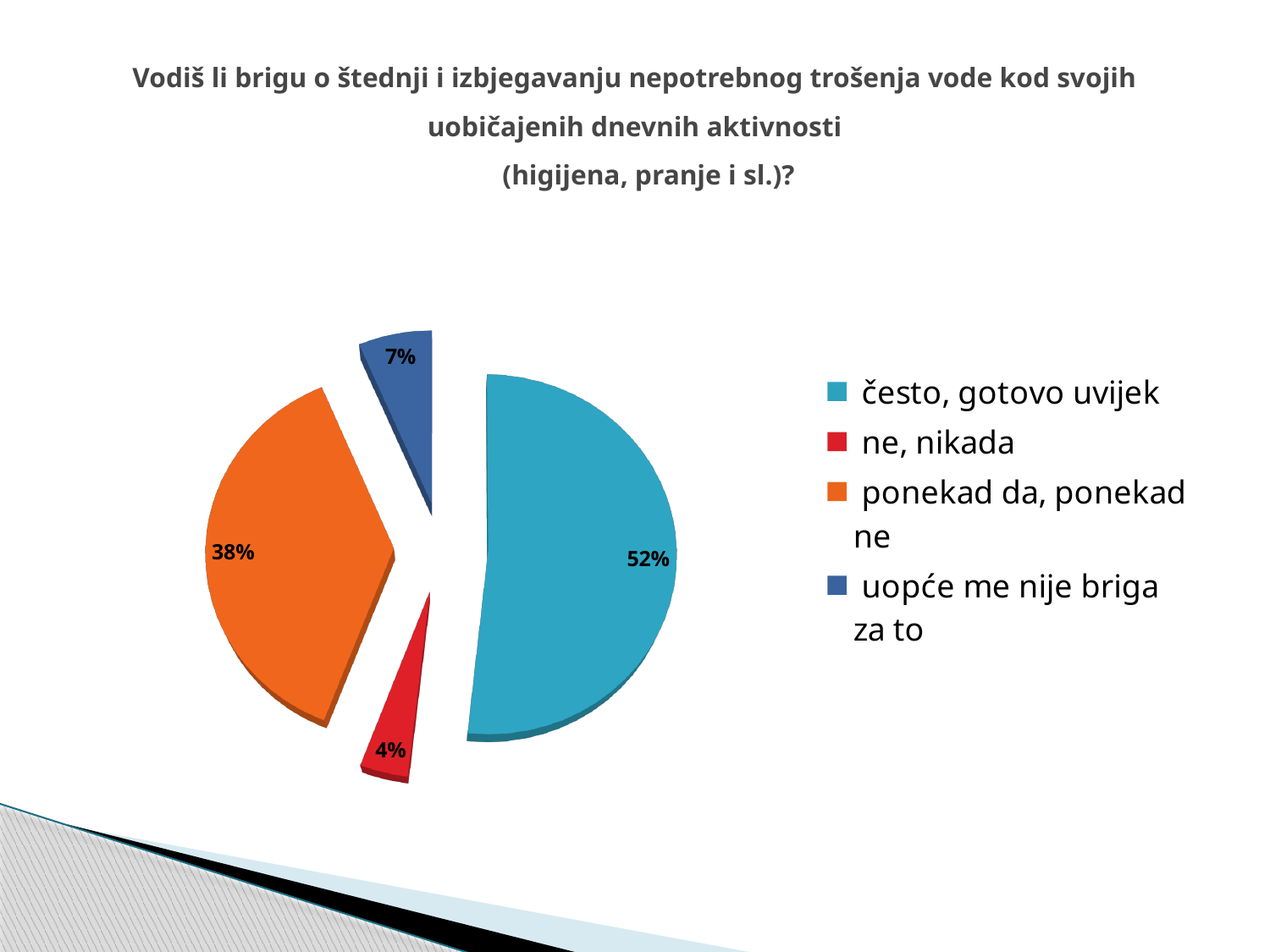
What share of the pie does "uopće me nije briga za to" have? 7% Which category has the smallest slice of the pie? ne, nikada Which category has the largest slice of the pie? često, gotovo uvijek What kind of chart is shown on the slide? pie chart What share of the pie does "često, gotovo uvijek" have? 52% What is the difference in percentage points between "uopće me nije briga za to" and "ne, nikada"? 3% What share of the pie does "ponekad da, ponekad ne" have? 38% Which is larger, the slice for "ne, nikada" or the slice for "uopće me nije briga za to"? uopće me nije briga za to How many categories does the pie chart have? 4 What colour is the slice for "ponekad da, ponekad ne"? orange What is the difference in percentage points between "često, gotovo uvijek" and "ponekad da, ponekad ne"? 14%